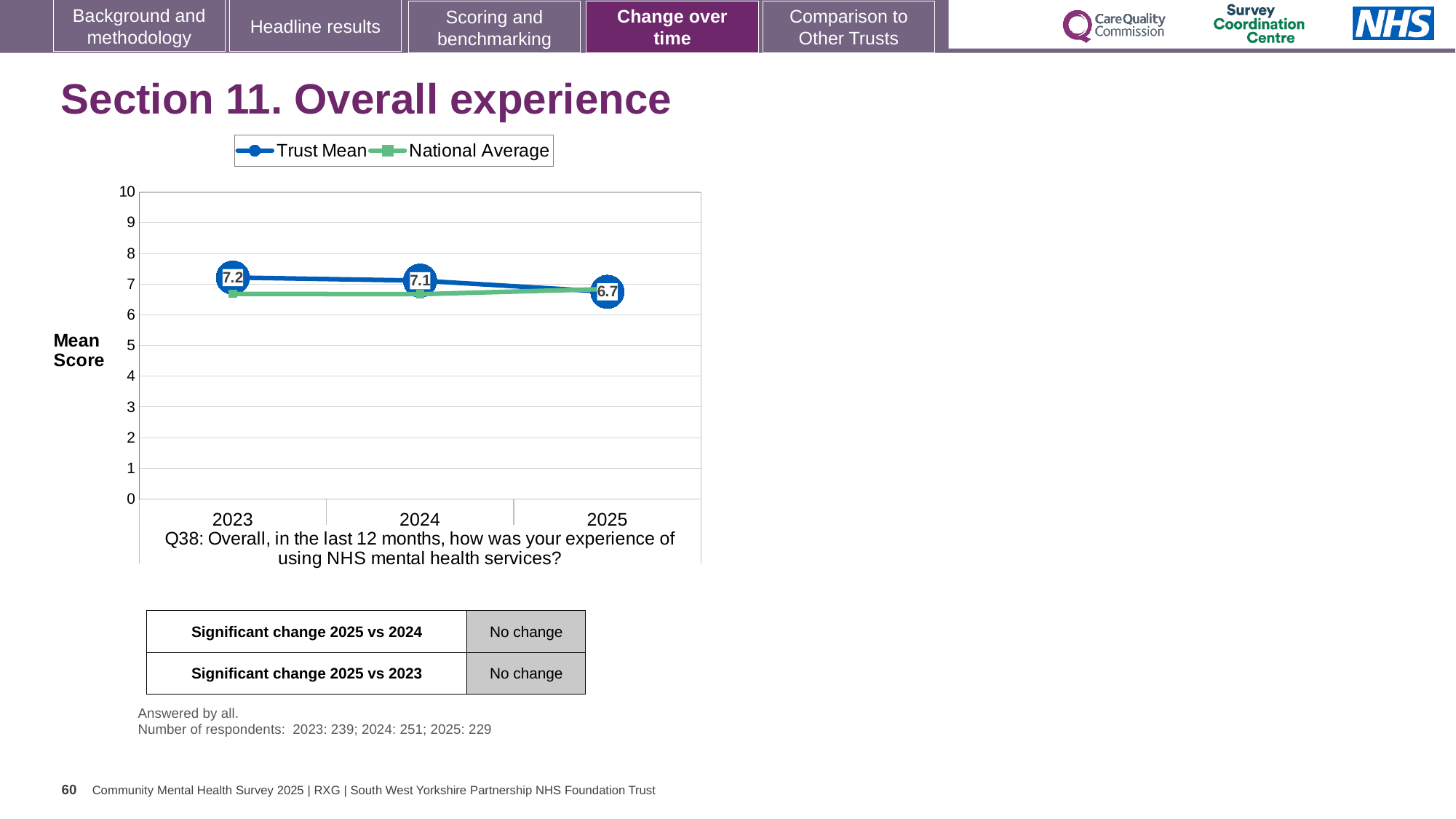
Which is larger in 2023: the Trust Mean or the National Average? Trust Mean Is the National Average value for 2024 greater or less than 5? greater What is the Trust Mean score for 2023? 7.2 What is the Trust Mean score for 2024? 7.1 How many years are plotted on the x axis? 3 In which year is the Trust Mean score lowest? 2025 How many series does the legend list? 2 In which year is the Trust Mean score highest? 2023 What is the Trust Mean score for 2025? 6.7 What is the difference between the Trust Mean score in 2023 and in 2025? 0.5 Does the Trust Mean rise or fall from 2023 to 2025? Fall What kind of chart is shown on the slide? Line chart